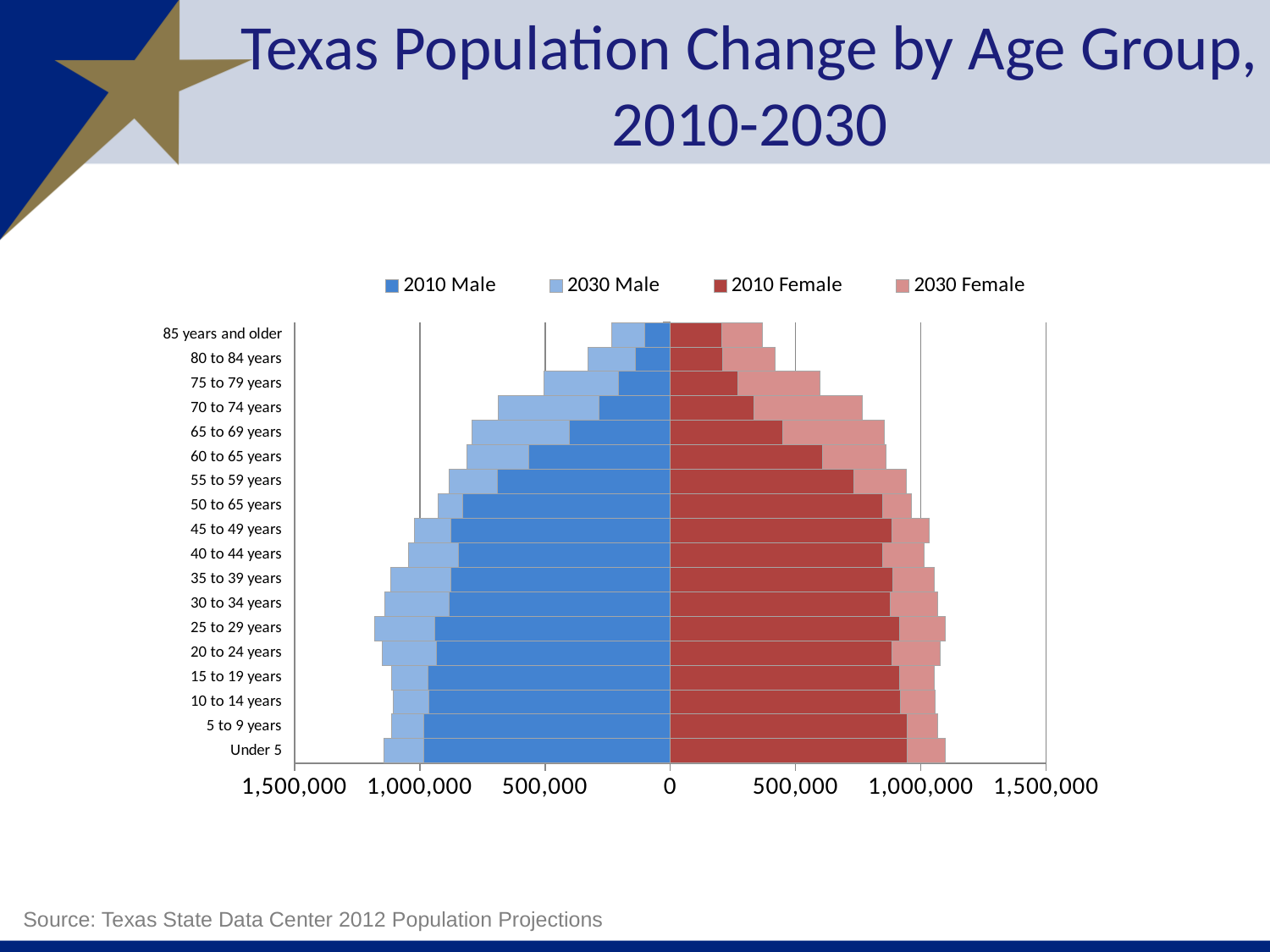
Is the 2010 Female value for 70 to 74 years greater or less than 500,000? less What kind of chart is shown on the slide? bar chart Which age group has the lowest value for 2010 Male? 85 years and older Is the 2010 Male value for 85 years and older greater or less than 500,000? less How many age groups are plotted on the chart? 18 What is the title of the chart on the slide? Texas Population Change by Age Group, 2010-2030 For 85 years and older, which is larger: the 2010 Male value or the 2010 Female value? 2010 Female Which series is shown in dark red? 2010 Female Do the 2010 Male values generally increase or decrease as the age groups get older? decrease How many series does the legend list? 4